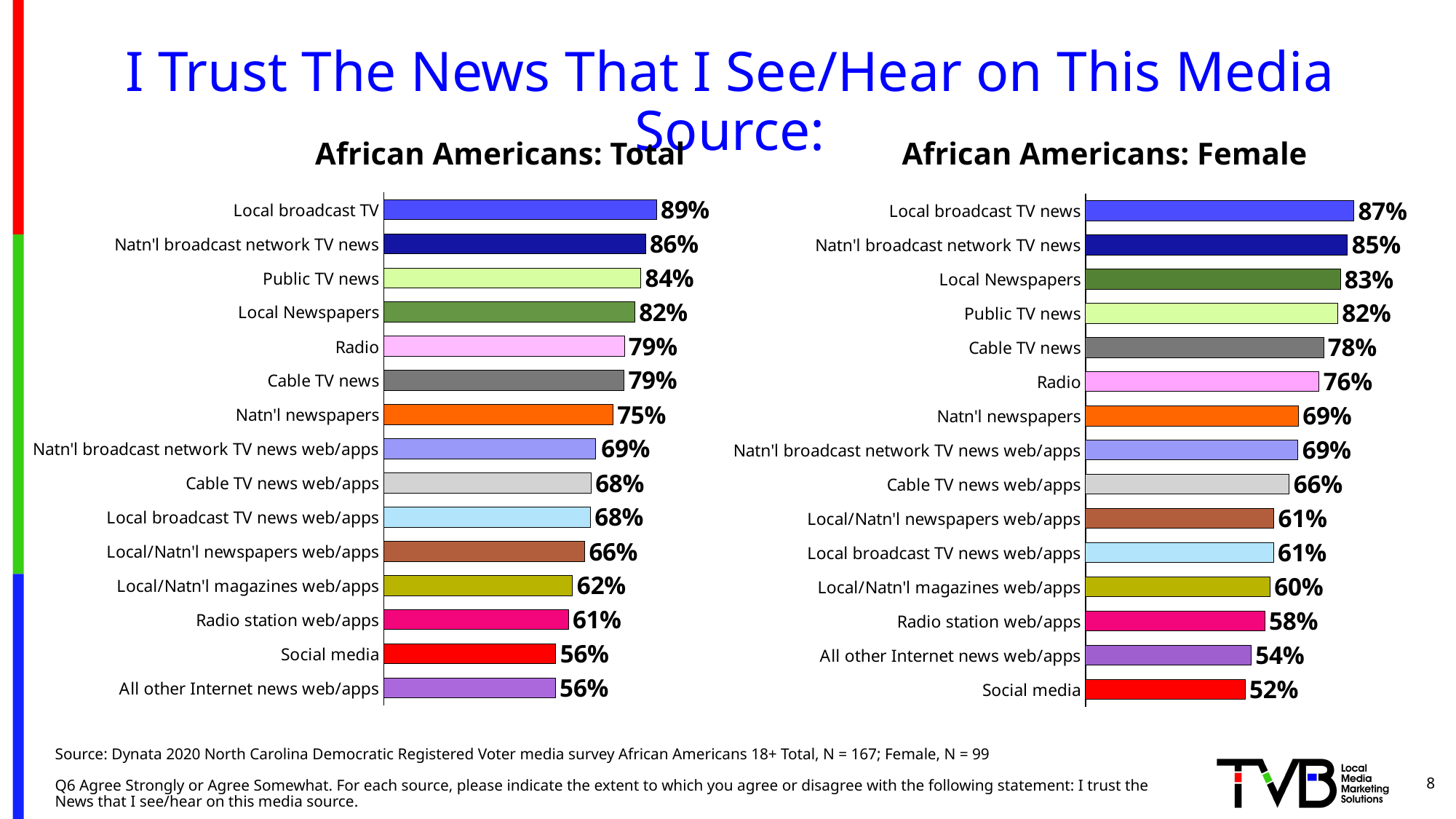
In the 'African Americans: Female' chart, what is the difference between Local broadcast TV news and Natn'l broadcast network TV news? 2% What is the title of the chart on the right side of the slide? African Americans: Female How many categories are shown in the 'African Americans: Female' chart? 15 In the 'African Americans: Total' chart, what is the value for Local/Natn'l magazines web/apps? 62% In the 'African Americans: Female' chart, which is larger, Radio or Natn'l newspapers? Radio In the 'African Americans: Total' chart, what is the value for Radio station web/apps? 61% In the 'African Americans: Total' chart, what is the difference between Public TV news and Social media? 28% What type of chart is the 'African Americans: Total' chart? Bar chart In the 'African Americans: Total' chart, what is the value for Local broadcast TV? 89% In the 'African Americans: Total' chart, which category has the highest value? Local broadcast TV In the 'African Americans: Female' chart, which category has the lowest value? Social media In the 'African Americans: Female' chart, what is the value for Cable TV news? 78%